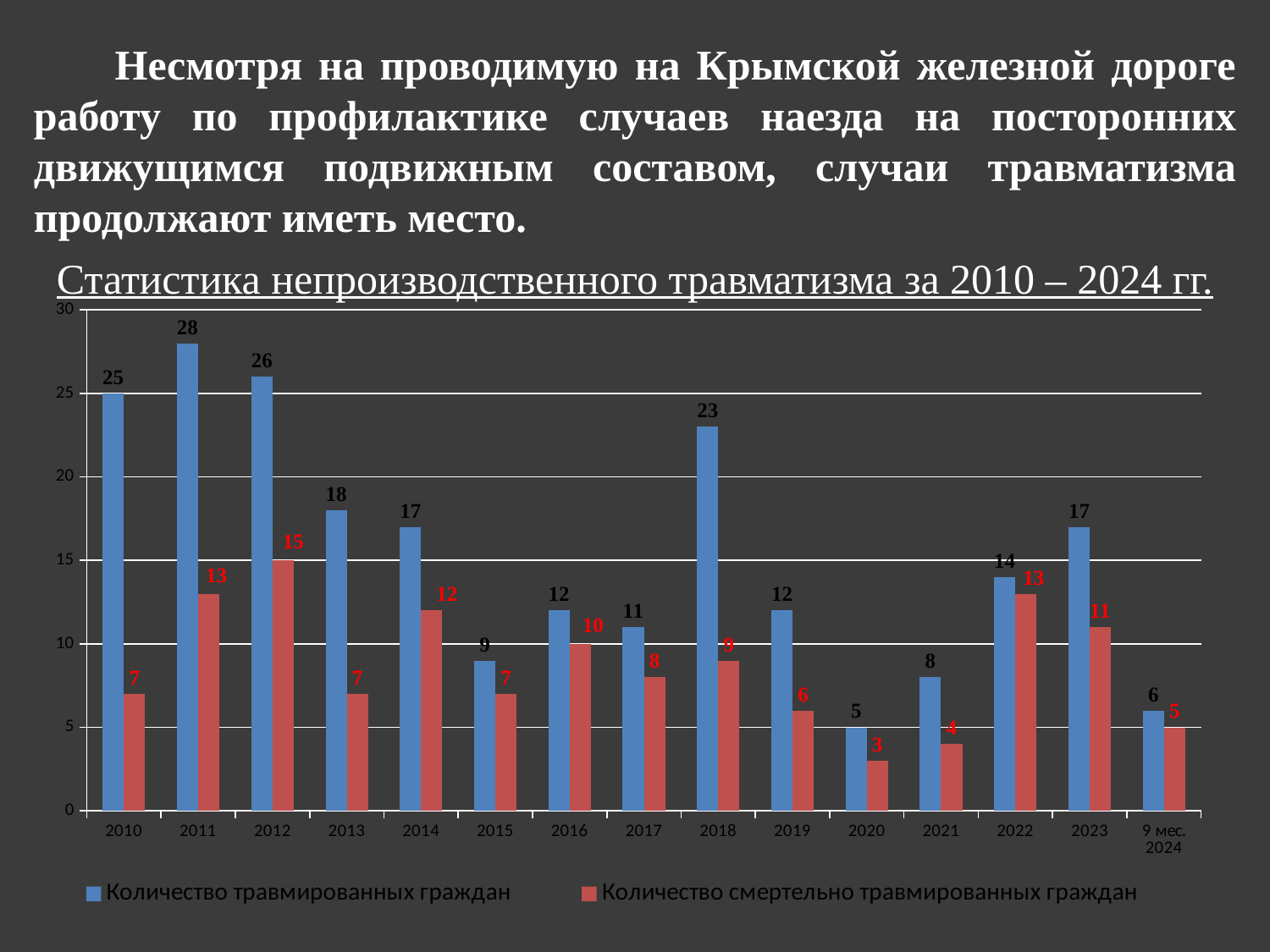
What is the value for 'Количество смертельно травмированных граждан' in 2012? 15 What is the difference between 'Количество травмированных граждан' and 'Количество смертельно травмированных граждан' in 2010? 18 How many categories are shown on the x axis? 15 How many series does the legend list? 2 Which is larger: 'Количество травмированных граждан' in 2013 or in 2023? 2013 What is the difference between 'Количество травмированных граждан' in 2011 and in 2020? 23 What is the value for 'Количество травмированных граждан' in 2018? 23 What type of chart is shown on the slide? bar chart What is the value for 'Количество смертельно травмированных граждан' for '9 мес. 2024'? 5 What is the title of the chart? Статистика непроизводственного травматизма за 2010 – 2024 гг. Which year has the highest value for 'Количество травмированных граждан'? 2011 Which category has the lowest value for 'Количество смертельно травмированных граждан'? 2020